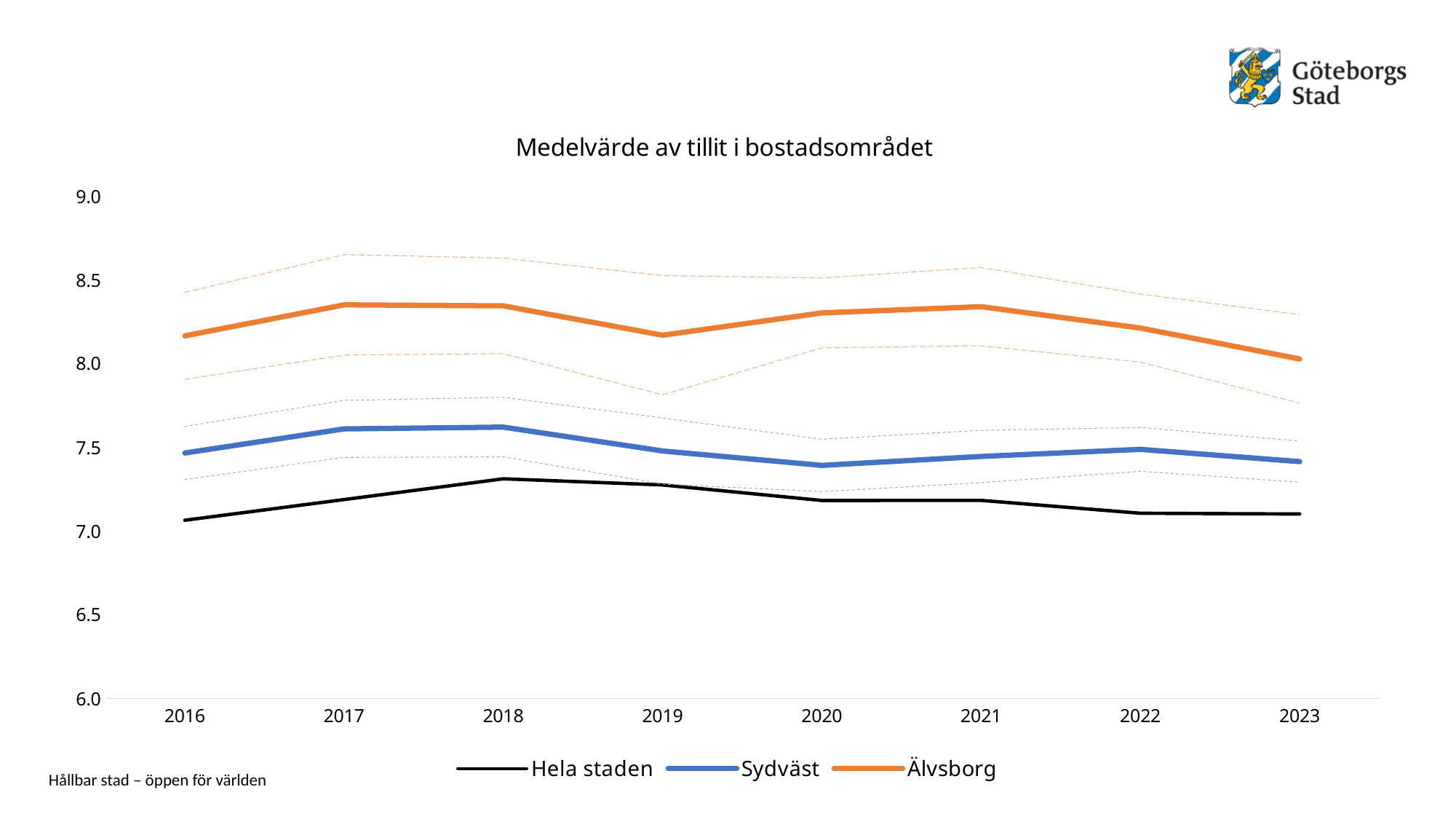
Which series is plotted in orange? Älvsborg Is the value for Sydväst in 2020 greater or less than 7.5? less How many series does the legend list? 3 How many years are shown on the x axis? 8 Is the value for Älvsborg in 2016 greater or less than 8.0? greater Is the value for Hela staden in 2022 greater or less than 7.5? less Which series has the highest values across all years? Älvsborg What is the title of the chart? Medelvärde av tillit i bostadsområdet What kind of chart is shown on the slide? line chart Does the Älvsborg line rise or fall from 2021 to 2023? fall In 2021, which is larger: the value for Älvsborg or the value for Sydväst? Älvsborg Which series has the lowest values across all years? Hela staden